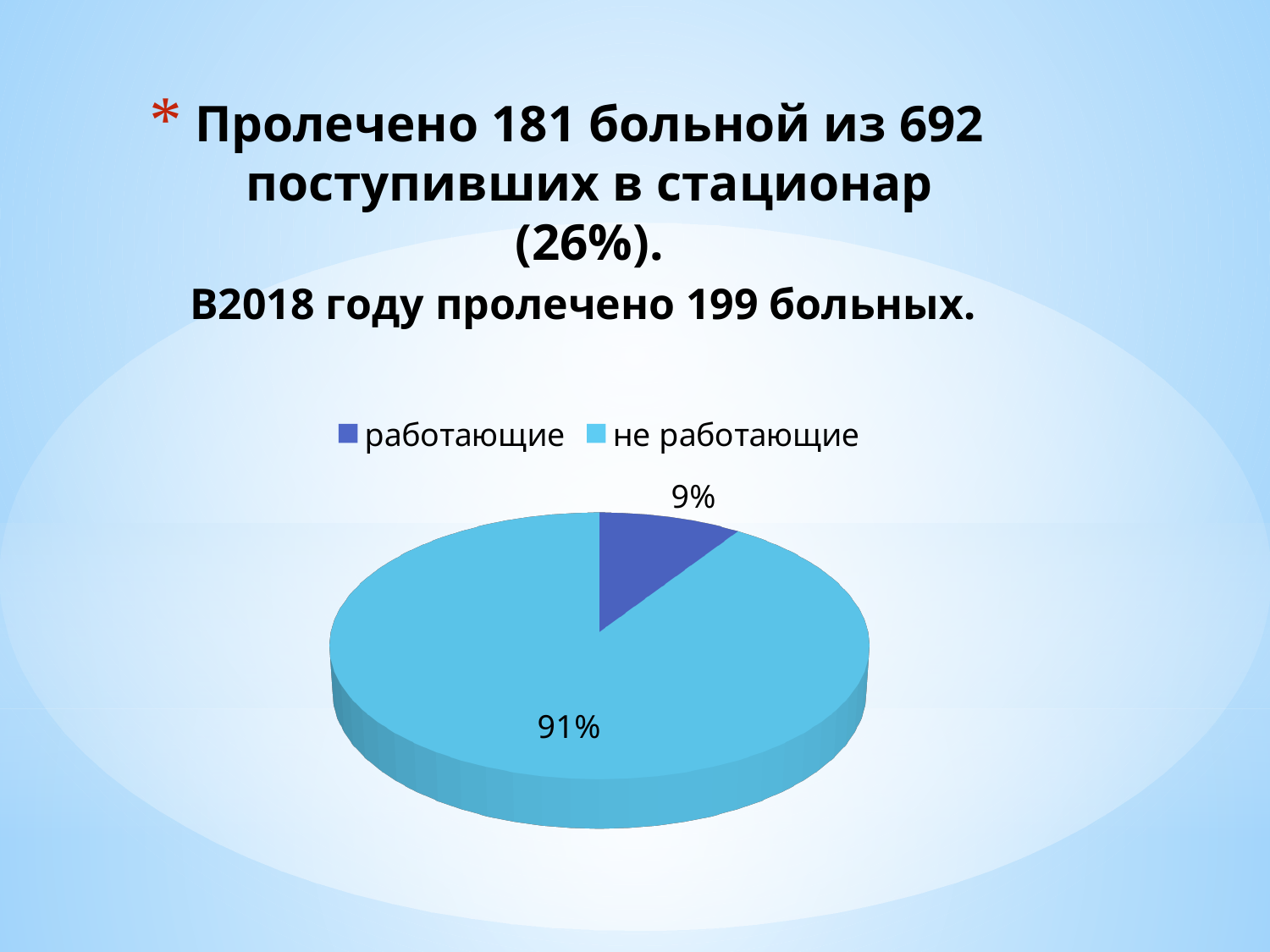
What kind of chart is shown on the slide? pie chart What share of the pie does the "работающие" slice represent? 9% How many entries does the legend list? 2 Where is the legend positioned relative to the pie? above the pie Which slice is larger, "работающие" or "не работающие"? не работающие What is the difference in percentage points between the "не работающие" and "работающие" slices? 82 How many slices does the pie chart have? 2 Which category has the smallest slice of the pie? работающие What colour is the "работающие" slice? dark blue What share of the pie does the "не работающие" slice represent? 91% Which category has the largest slice of the pie? не работающие